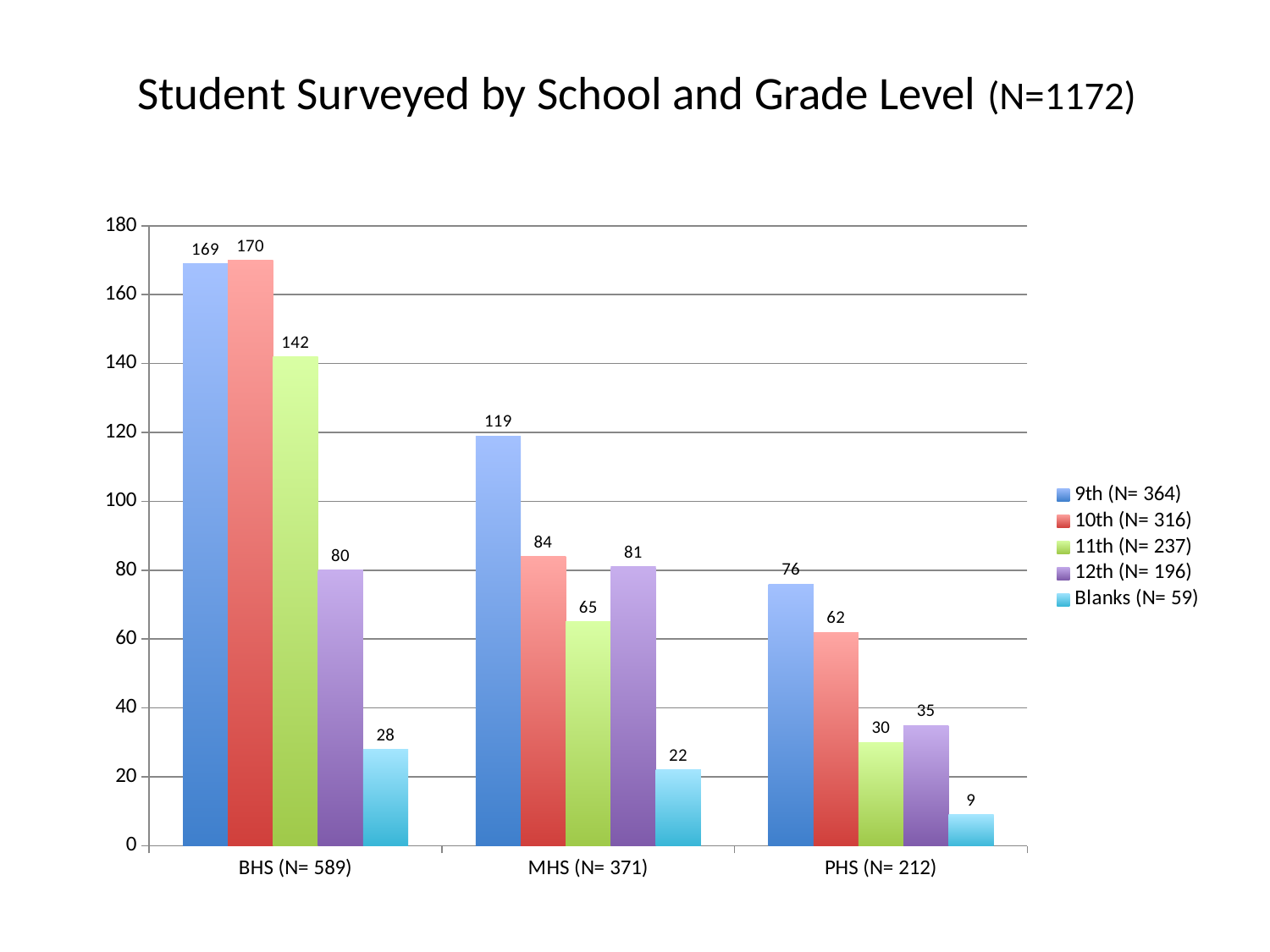
Which school has the highest value for 12th grade? MHS (N= 371) What is the difference between the 9th grade and 10th grade values at PHS (N= 212)? 14 What kind of chart is shown on the slide? Bar chart What is the value for 11th grade at MHS (N= 371)? 65 Which is larger: the 11th grade value at BHS (N= 589) or the 9th grade value at MHS (N= 371)? 11th grade at BHS (N= 589) Do the 9th grade values rise or fall from BHS to PHS along the x axis? Fall What is the value for 9th grade at BHS (N= 589)? 169 How many school categories are shown on the x axis? 3 Which grade series has the lowest value at MHS (N= 371)? Blanks (N= 59) What is the value for Blanks at PHS (N= 212)? 9 What is the title of the chart? Student Surveyed by School and Grade Level (N=1172) How many series does the legend list? 5